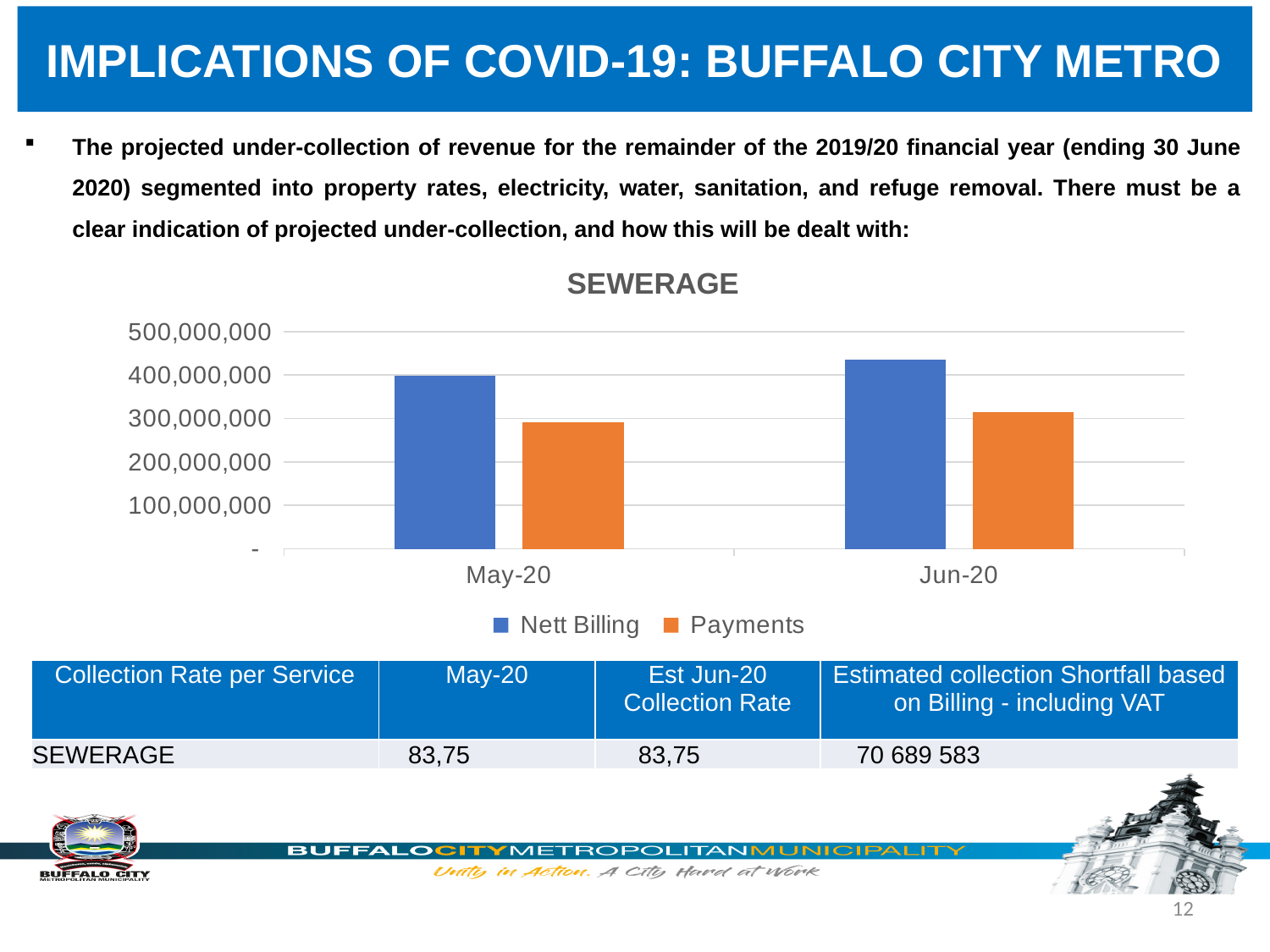
Which bar is the highest in the chart? Nett Billing for Jun-20 What is the title of the chart? SEWERAGE How many categories are shown on the x axis of the chart? 2 What type of chart is shown on the slide? bar chart In May-20, which is larger: Nett Billing or Payments? Nett Billing Which series is shown in orange in the chart? Payments Which bar is the lowest in the chart? Payments for May-20 Is the value for Nett Billing in Jun-20 greater or less than 400,000,000? greater How many series does the chart legend list? 2 Is Nett Billing higher in May-20 or in Jun-20? Jun-20 Is the value for Payments in May-20 greater or less than 200,000,000? greater Does Payments rise or fall from May-20 to Jun-20? rise